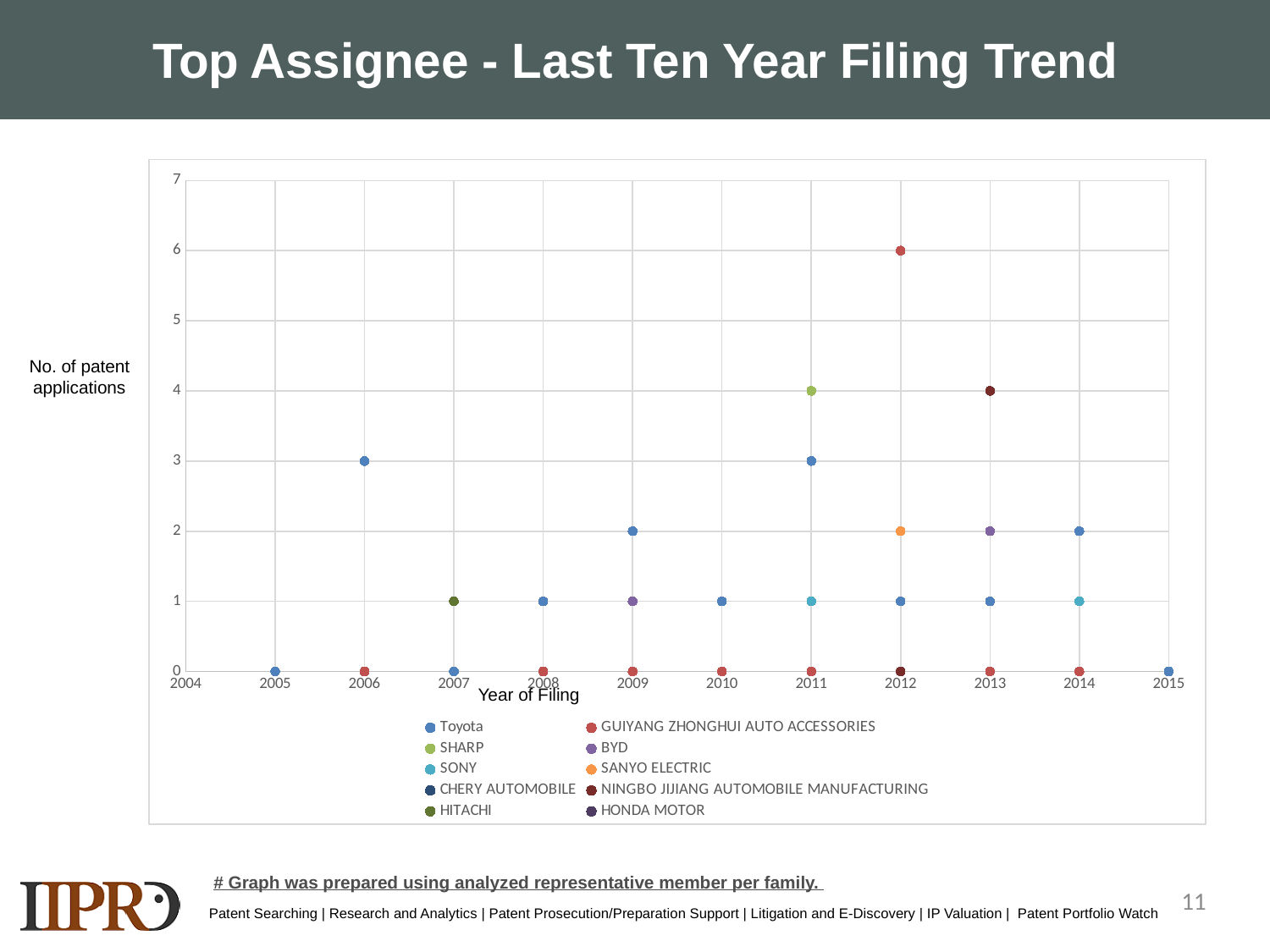
How many patent applications did SHARP file in 2011? 4 How many patent applications did Toyota file in 2006? 3 What kind of chart is shown on the slide? scatter chart How many assignees (series) does the legend list? 10 What is the title of the x axis? Year of Filing What is the difference between GUIYANG ZHONGHUI AUTO ACCESSORIES' 2012 value and SHARP's 2011 value? 2 How many patent applications did GUIYANG ZHONGHUI AUTO ACCESSORIES file in 2012? 6 How many patent applications did HITACHI file in 2007? 1 How many patent applications did NINGBO JIJIANG AUTOMOBILE MANUFACTURING file in 2013? 4 How many patent applications did SANYO ELECTRIC file in 2012? 2 Which is larger for Toyota: the 2006 value or the 2009 value? 2006 Which assignee has the highest single-year number of patent applications on the chart? GUIYANG ZHONGHUI AUTO ACCESSORIES